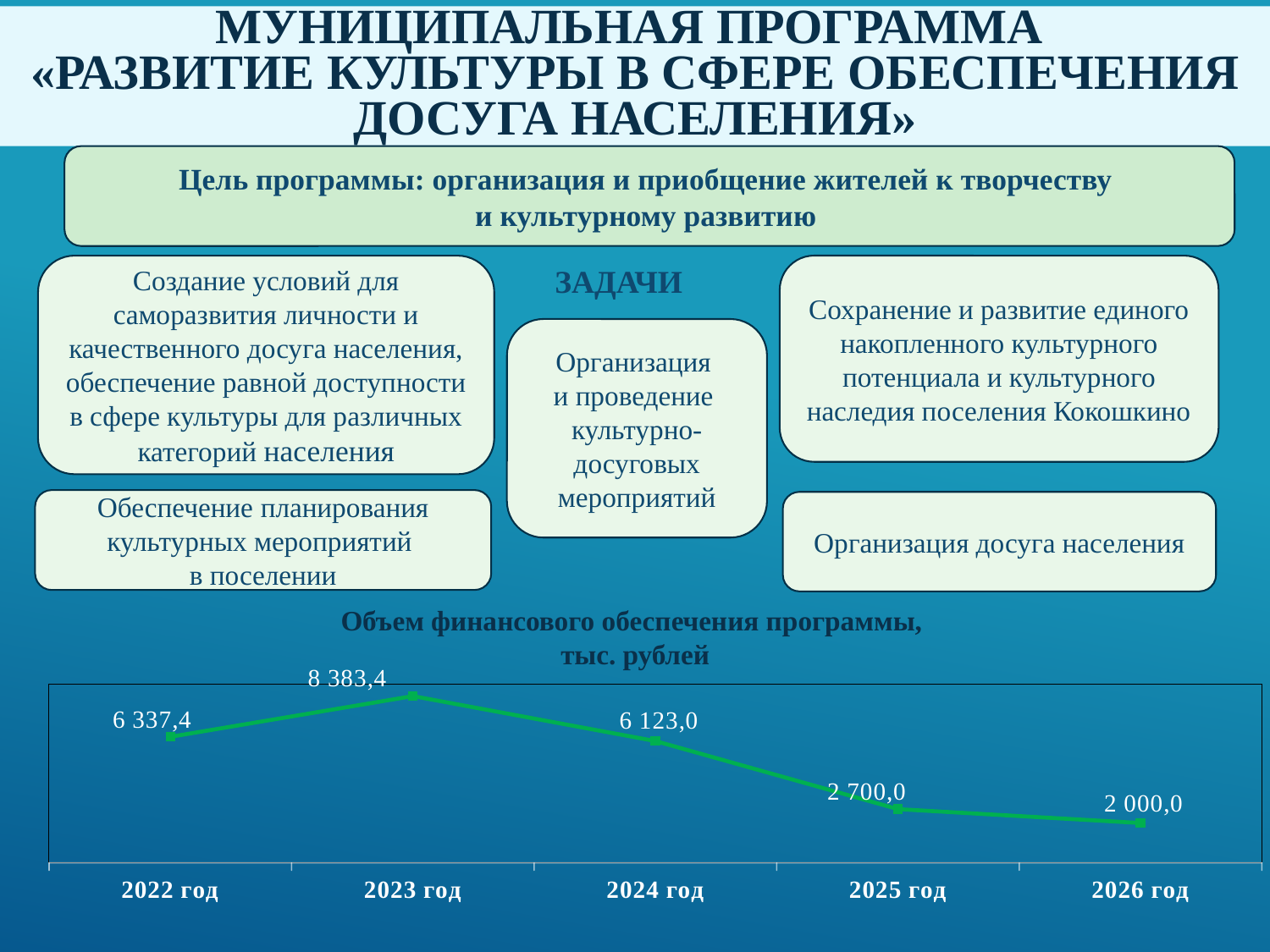
What is the value for 2023 год? 8 383,4 What is the value for 2025 год? 2 700,0 What is the difference between the values for 2025 год and 2026 год? 700,0 Which is larger, the value for 2022 год or the value for 2024 год? 2022 год Which year has the lowest value? 2026 год How many years are plotted on the chart? 5 What is the difference between the values for 2023 год and 2022 год? 2 046,0 What is the title of the chart? Объем финансового обеспечения программы, тыс. рублей How do the values change from 2023 год to 2026 год? They fall What is the value for 2022 год? 6 337,4 Which year has the highest value? 2023 год What type of chart is shown on the slide? Line chart